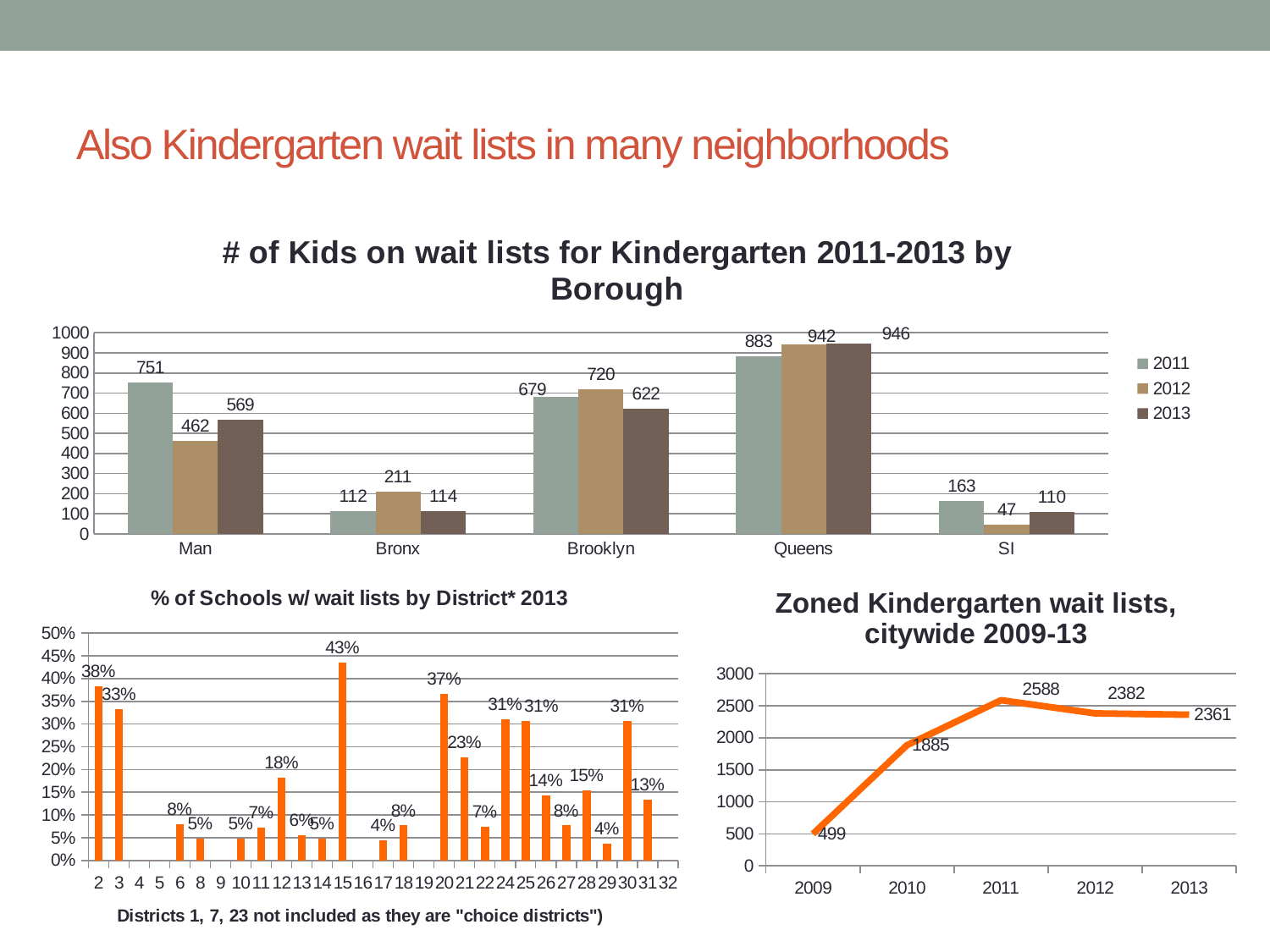
In the '% of Schools w/ wait lists by District* 2013' chart, what is the value for district 20? 37% In the 'Zoned Kindergarten wait lists, citywide 2009-13' chart, which year has the highest value? 2011 In the '# of Kids on wait lists for Kindergarten 2011-2013 by Borough' chart, what is the difference between the 2011 and 2012 values for Man? 289 In the '# of Kids on wait lists for Kindergarten 2011-2013 by Borough' chart, what is the 2012 value for SI? 47 How many series does the legend of the '# of Kids on wait lists for Kindergarten 2011-2013 by Borough' chart list? 3 In the '# of Kids on wait lists for Kindergarten 2011-2013 by Borough' chart, which borough had the fewest kids on wait lists in 2012? SI In the '# of Kids on wait lists for Kindergarten 2011-2013 by Borough' chart, which is larger: Brooklyn in 2012 or Brooklyn in 2013? Brooklyn in 2012 In the '# of Kids on wait lists for Kindergarten 2011-2013 by Borough' chart, how many kids were on wait lists in Queens in 2013? 946 In the '# of Kids on wait lists for Kindergarten 2011-2013 by Borough' chart, which borough had the most kids on wait lists in 2011? Queens What kind of chart is 'Zoned Kindergarten wait lists, citywide 2009-13'? Line chart In the '% of Schools w/ wait lists by District* 2013' chart, which district has the highest percentage? 15 In the 'Zoned Kindergarten wait lists, citywide 2009-13' chart, what is the value for 2010? 1885